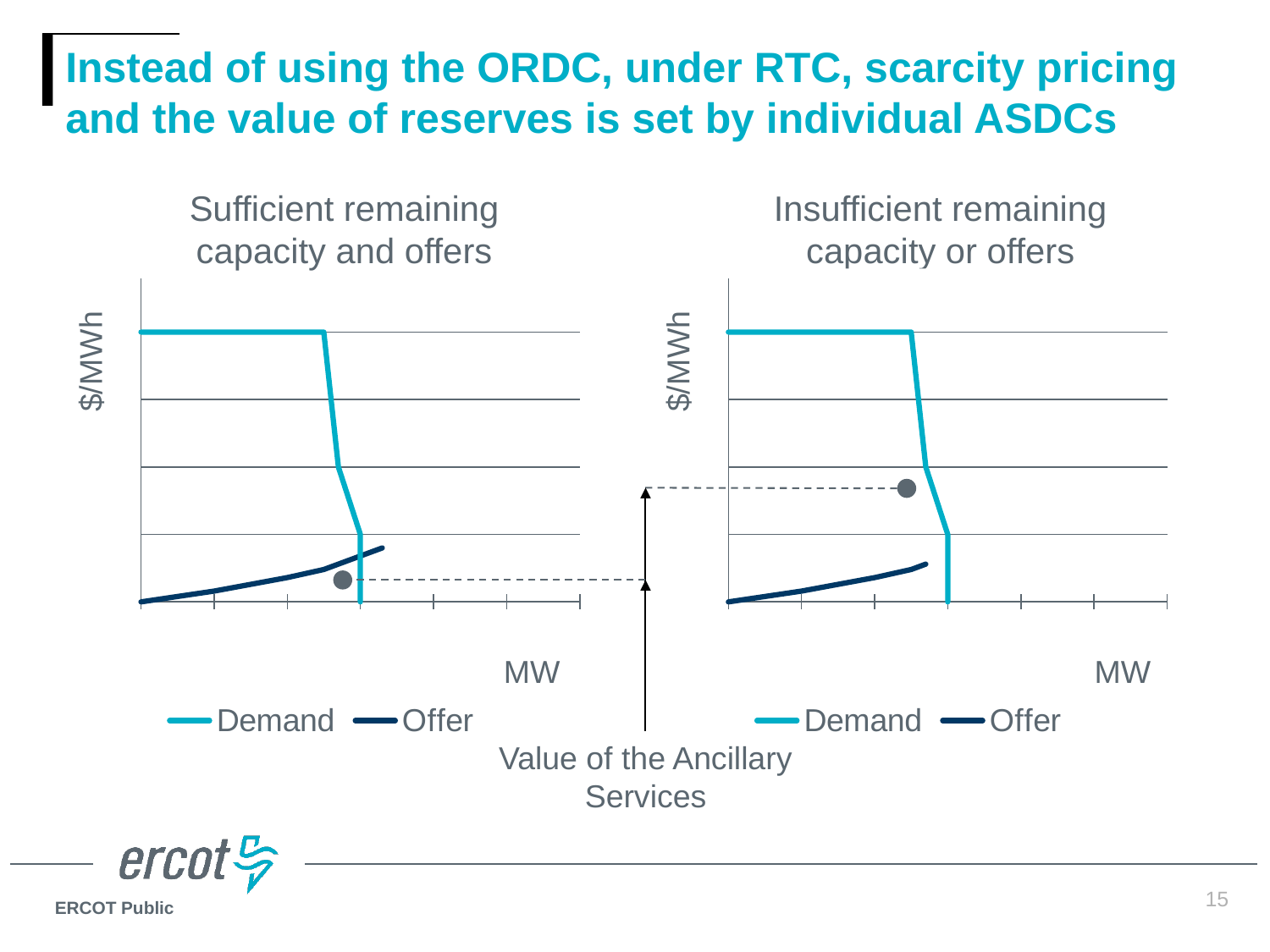
In the left chart ("Sufficient remaining capacity and offers"), does the Demand line rise or fall as MW increases? Fall What are the two series named in the legend of the right chart ("Insufficient remaining capacity or offers")? Demand and Offer How many series does the legend of the right chart ("Insufficient remaining capacity or offers") list? 2 In the left chart ("Sufficient remaining capacity and offers"), which series is higher at the left edge of the chart, Demand or Offer? Demand In the right chart ("Insufficient remaining capacity or offers"), does the Demand line rise or fall as MW increases? Fall In the left chart ("Sufficient remaining capacity and offers"), does the Offer line rise or fall as MW increases? Rise What is the y-axis label of the left chart ("Sufficient remaining capacity and offers")? $/MWh How many series does the legend of the left chart ("Sufficient remaining capacity and offers") list? 2 What kind of chart is the right chart titled "Insufficient remaining capacity or offers"? Line chart In the right chart ("Insufficient remaining capacity or offers"), which series is higher at the left edge of the chart, Demand or Offer? Demand What kind of chart is the left chart titled "Sufficient remaining capacity and offers"? Line chart